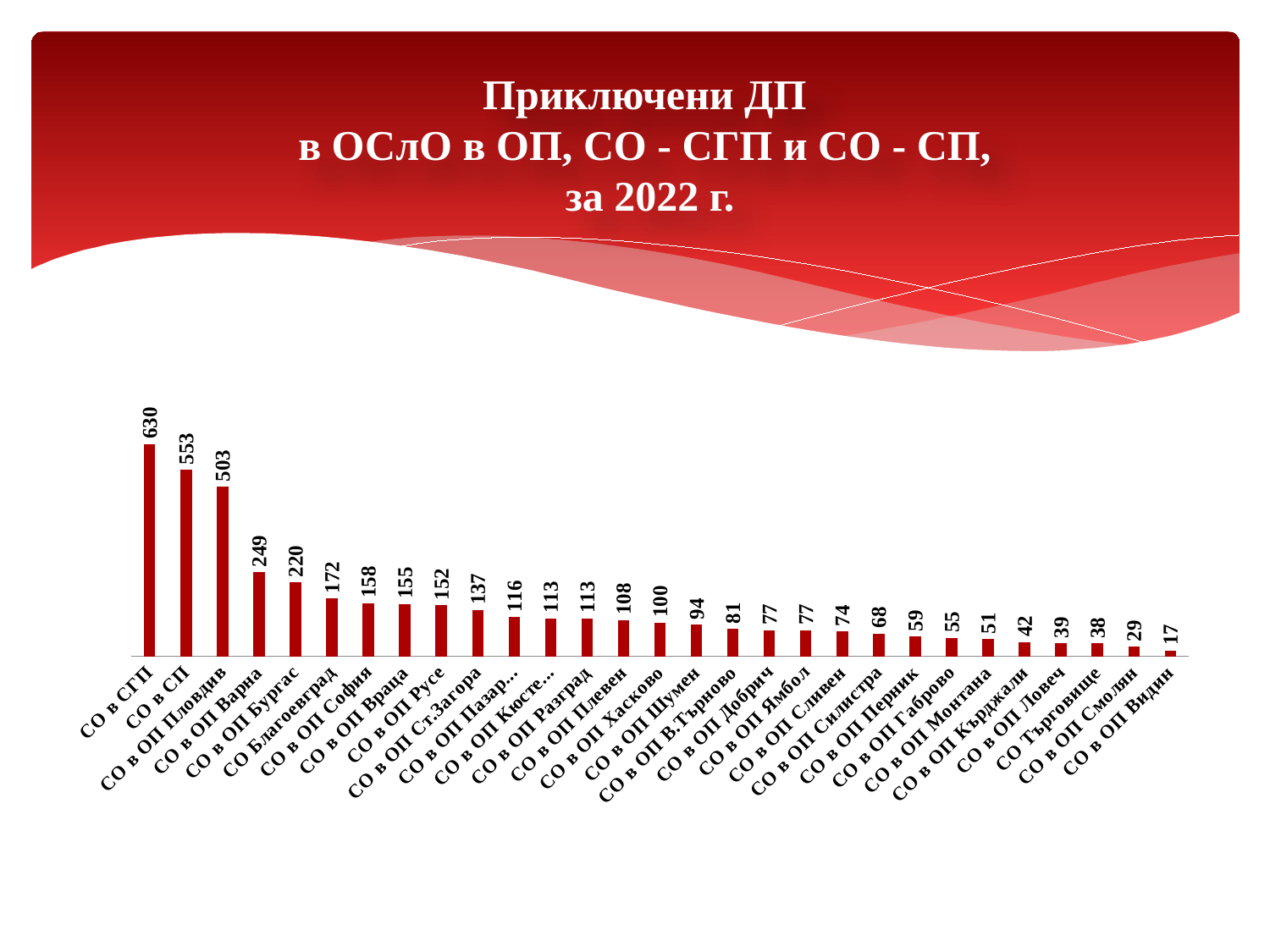
Which category has the highest value? СО в СГП Do the values rise or fall from left to right along the x axis? Fall What kind of chart is shown on the slide? Bar chart Which is larger, the value for СО в ОП Русе or the value for СО в ОП Шумен? СО в ОП Русе How many categories are shown in the chart? 29 Which category has the lowest value? СО в ОП Видин What is the difference between the values for СО в СГП and СО в СП? 77 What is the value for СО в ОП Хасково? 100 What is the difference between the values for СО в ОП Бургас and СО в ОП Благоевград? 48 What is the value for СО в ОП Варна? 249 What is the value for СО в ОП Монтана? 51 What is the value for СО в ОП Пловдив? 503